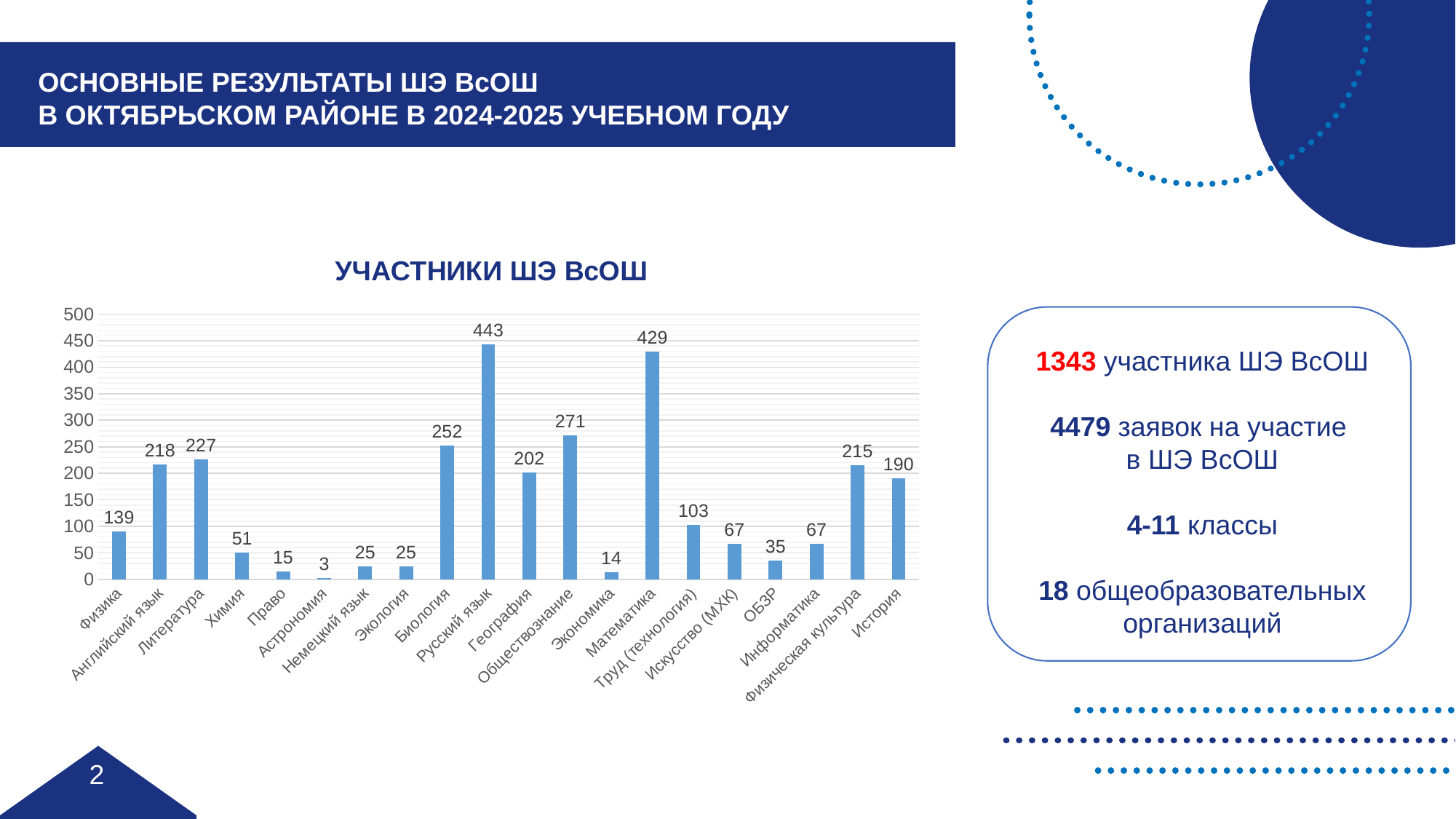
What kind of chart is shown on the slide? bar chart How many subjects are shown on the x axis of the chart? 20 Which subject has the lowest number of participants? Астрономия Which subject has the highest number of participants? Русский язык What is the difference between the values for Русский язык and Математика? 14 Which has a larger value, Обществознание or Биология? Обществознание What is the value for Физическая культура? 215 What is the difference between the values for Биология and География? 50 What is the value for Труд (технология)? 103 What is the title of the chart on the slide? УЧАСТНИКИ ШЭ ВсОШ How many participants are shown for Русский язык? 443 Is the value for История greater or less than 150? greater